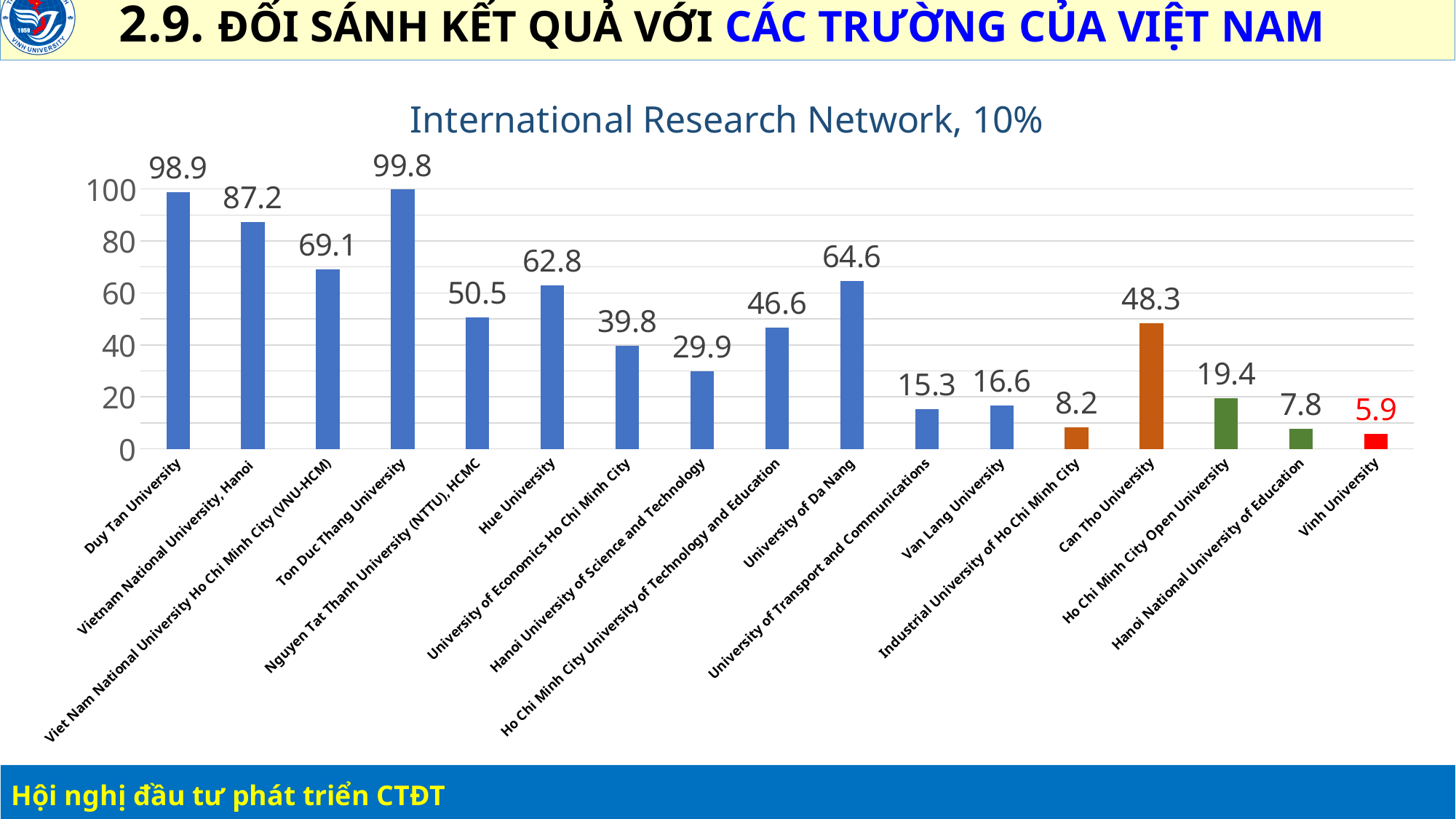
How many universities are shown in the chart? 17 What is the difference between University of Da Nang and Hue University? 1.8 Which university has the lowest value? Vinh University Which university has the highest value? Ton Duc Thang University What is the title of the chart? International Research Network, 10% Is the value for Hanoi University of Science and Technology greater or less than 40? less Which is larger, Van Lang University or University of Transport and Communications? Van Lang University What is the difference between Duy Tan University and Vinh University? 93 What is the value for Vinh University? 5.9 What is the value for Can Tho University? 48.3 What kind of chart is this? bar chart What is the value for Hue University? 62.8